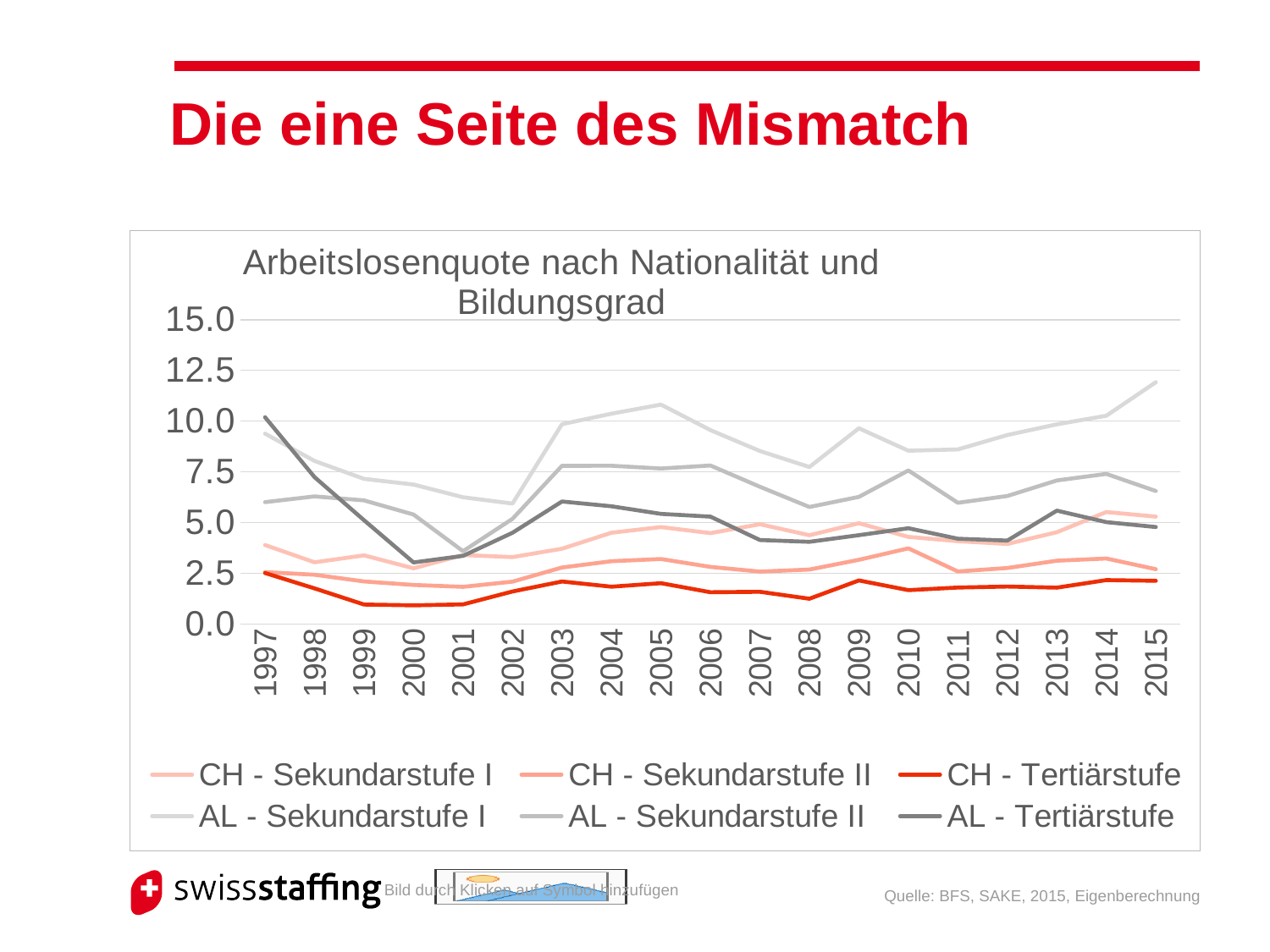
In which year does AL - Sekundarstufe I reach its highest value? 2015 Which series is drawn in the darkest red line? CH - Tertiärstufe Which series has the highest value in 2015? AL - Sekundarstufe I Is the value for AL - Tertiärstufe in 1997 greater or less than 7.5? greater Does the AL - Tertiärstufe line rise or fall from 1997 to 2000? fall How many series does the legend list? 6 What is the title of the chart? Arbeitslosenquote nach Nationalität und Bildungsgrad Which series has the lowest value in 2015? CH - Tertiärstufe Is the value for AL - Sekundarstufe I in 2015 greater or less than 10.0? greater Is the value for CH - Tertiärstufe in 1999 greater or less than 2.5? less What kind of chart is shown on the slide? line chart How many years are shown on the x axis? 19